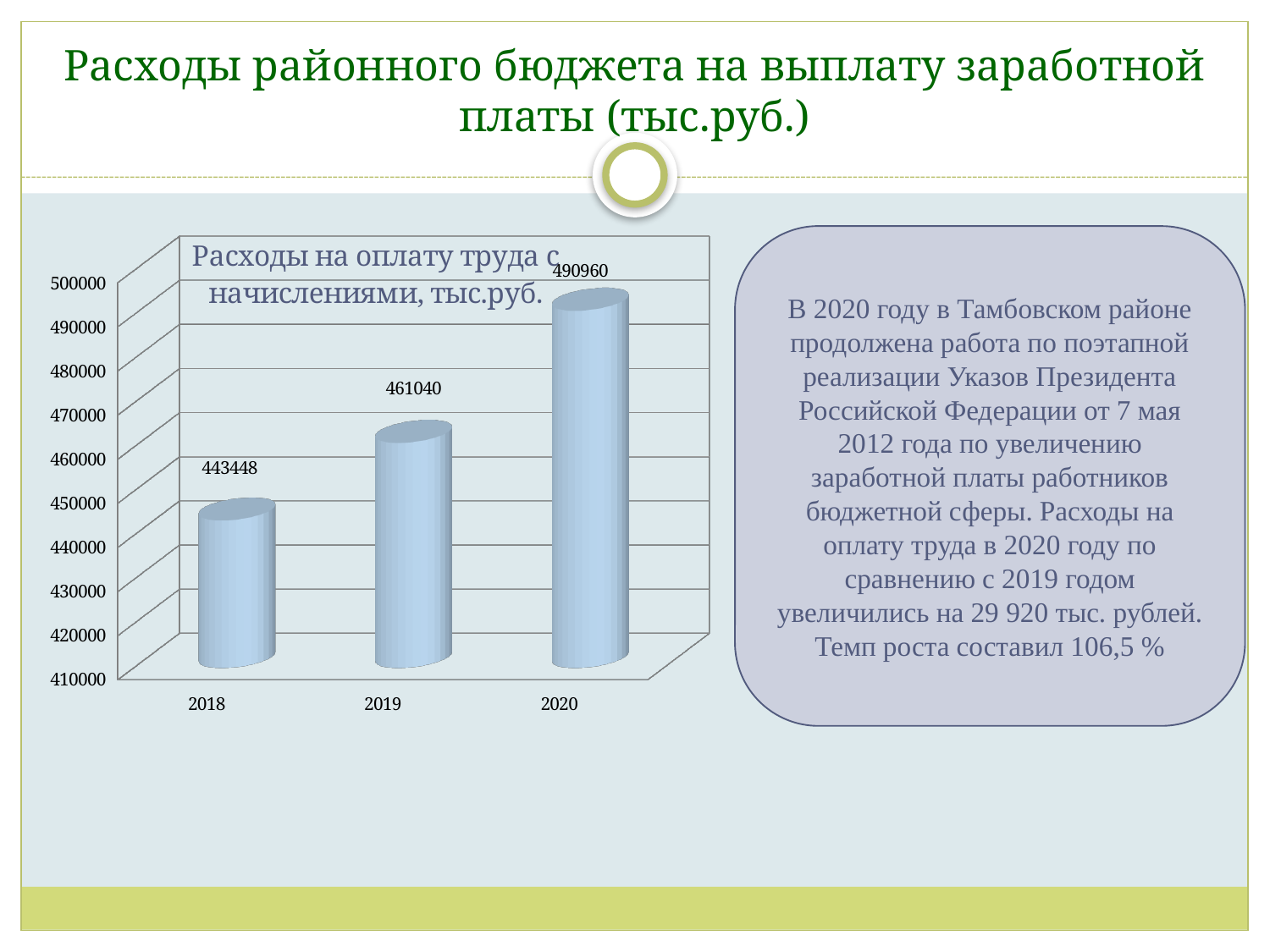
What is the difference between the values for 2020 and 2019? 29920 What is the value for 2020 in the chart? 490960 What is the value for 2018 in the chart? 443448 Which year has the highest value in the chart? 2020 Which year has the lowest value in the chart? 2018 How many years are shown on the x axis of the chart? 3 Is the value for 2020 greater or less than 480000? greater Do the values rise or fall from 2018 to 2020? rise What is the difference between the values for 2019 and 2018? 17592 What is the value for 2019 in the chart? 461040 What kind of chart is shown on the slide? bar chart Which is larger, the value for 2019 or the value for 2018? 2019